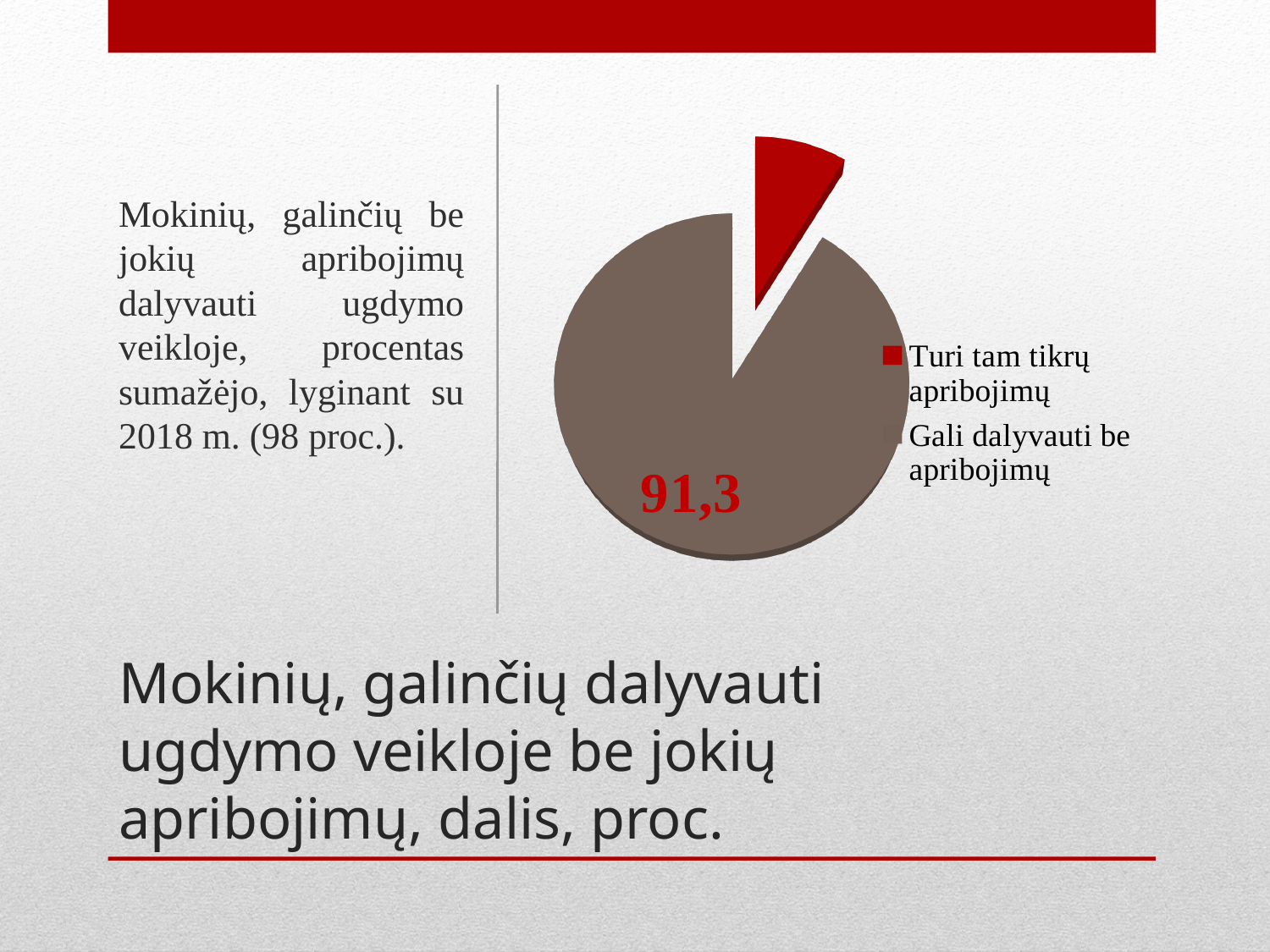
Which category has the smallest slice in the pie chart? Turi tam tikrų apribojimų Which category has the largest slice in the pie chart? Gali dalyvauti be apribojimų What value is shown for the 'Gali dalyvauti be apribojimų' slice of the pie chart? 91,3 Which slice is larger: 'Turi tam tikrų apribojimų' or 'Gali dalyvauti be apribojimų'? Gali dalyvauti be apribojimų How many slices does the pie chart have? 2 What colour is the 'Turi tam tikrų apribojimų' slice in the pie chart? Red What share of the pie does the 'Gali dalyvauti be apribojimų' slice represent, according to the data label? 91,3 Which legend entry is listed first in the pie chart's legend? Turi tam tikrų apribojimų What kind of chart is shown on the slide? Pie chart How many entries does the legend of the pie chart list? 2